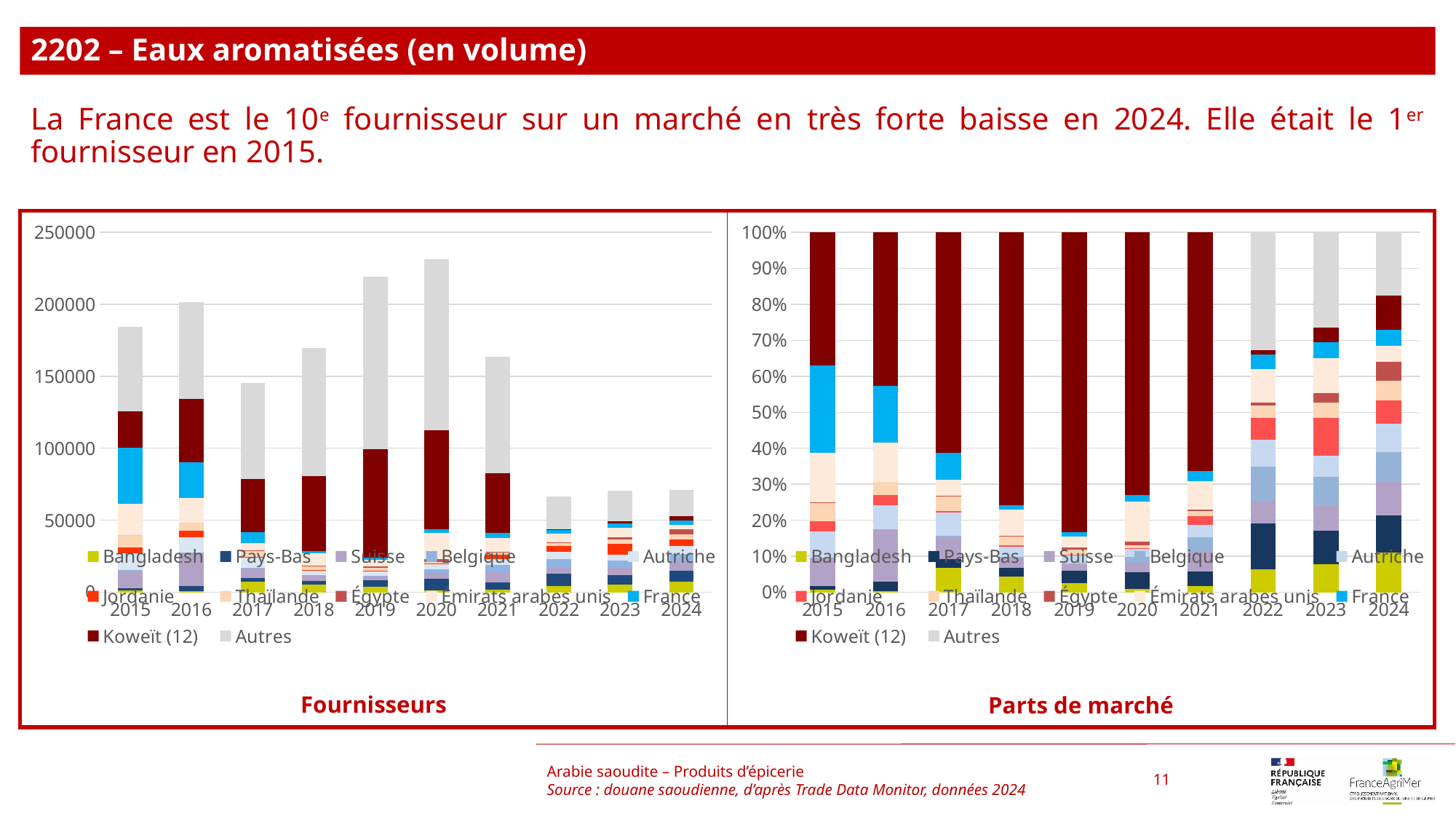
How many series does the legend of the 'Parts de marché' chart list? 12 How many years are shown on the x axis of the 'Fournisseurs' chart? 10 In the 'Parts de marché' chart, is the share of Autres in 2022 greater or less than 30%? greater In the 'Fournisseurs' chart, which total bar is larger, 2015 or 2017? 2015 In the 'Fournisseurs' chart, which year has the highest total bar? 2020 In the 'Fournisseurs' chart, do the total bars rise or fall from 2020 to 2022? fall In the 'Fournisseurs' chart, is the total bar for 2022 greater or less than 100000? less What kind of chart is the 'Fournisseurs' chart on the left? stacked bar chart In the 'Parts de marché' chart, is the share of Koweït (12) in 2021 greater or less than 60%? greater What is the title of the chart on the right of the slide? Parts de marché In the 'Parts de marché' chart, is the share of France larger in 2015 or in 2016? 2015